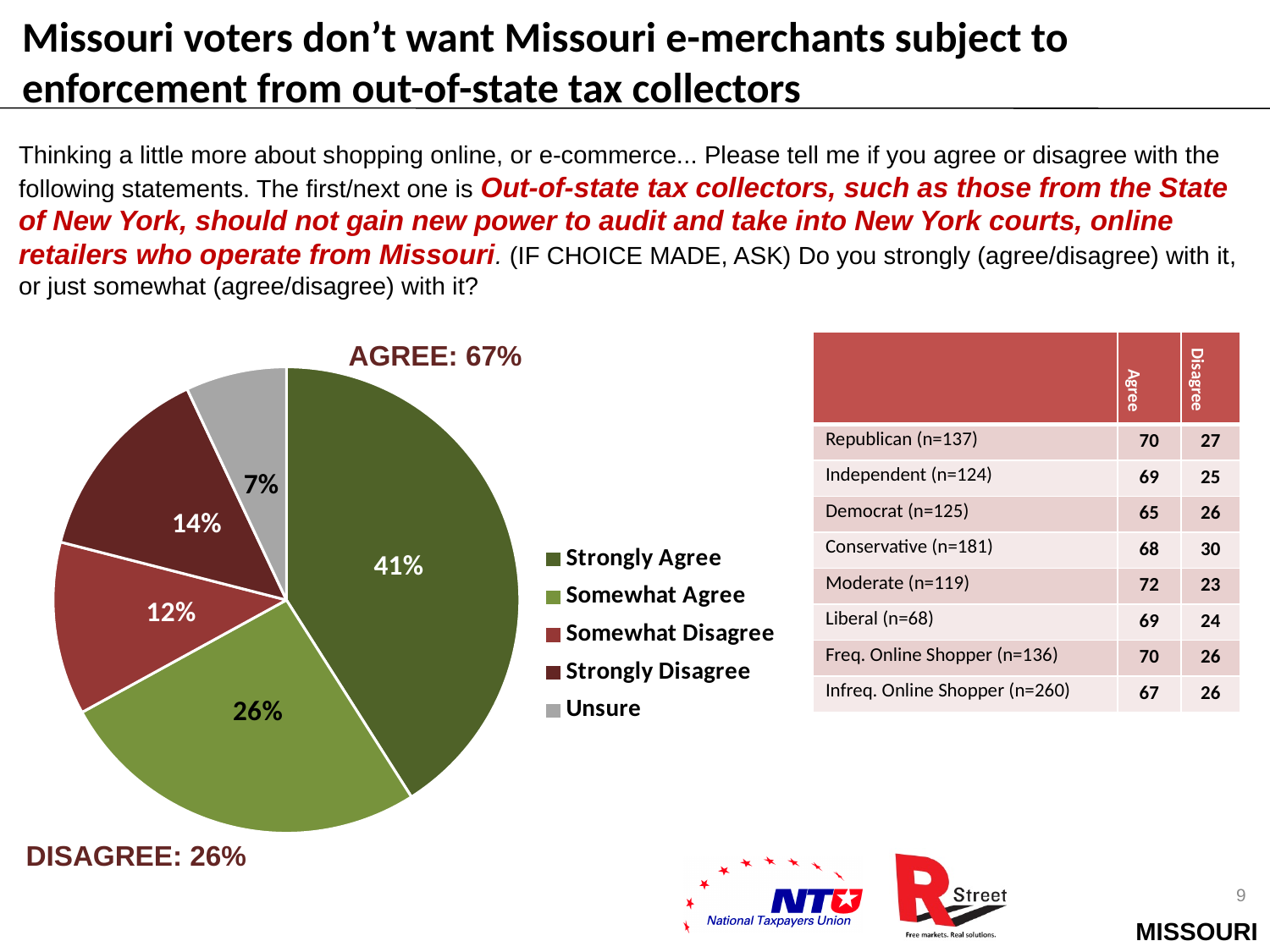
What percentage of respondents said they Strongly Agree? 41% What percentage of respondents said they Somewhat Disagree? 12% What total AGREE percentage is labeled above the pie chart? 67% What percentage of respondents were Unsure? 7% What kind of chart is shown on the slide? pie chart How many categories does the pie chart legend list? 5 What percentage of respondents said they Somewhat Agree? 26% Which response category has the largest share of the pie? Strongly Agree Which response category has the smallest share of the pie? Unsure What percentage of respondents said they Strongly Disagree? 14% What is the difference in percentage points between Strongly Agree and Somewhat Agree? 15 Which is larger, the Strongly Disagree slice or the Somewhat Disagree slice? Strongly Disagree